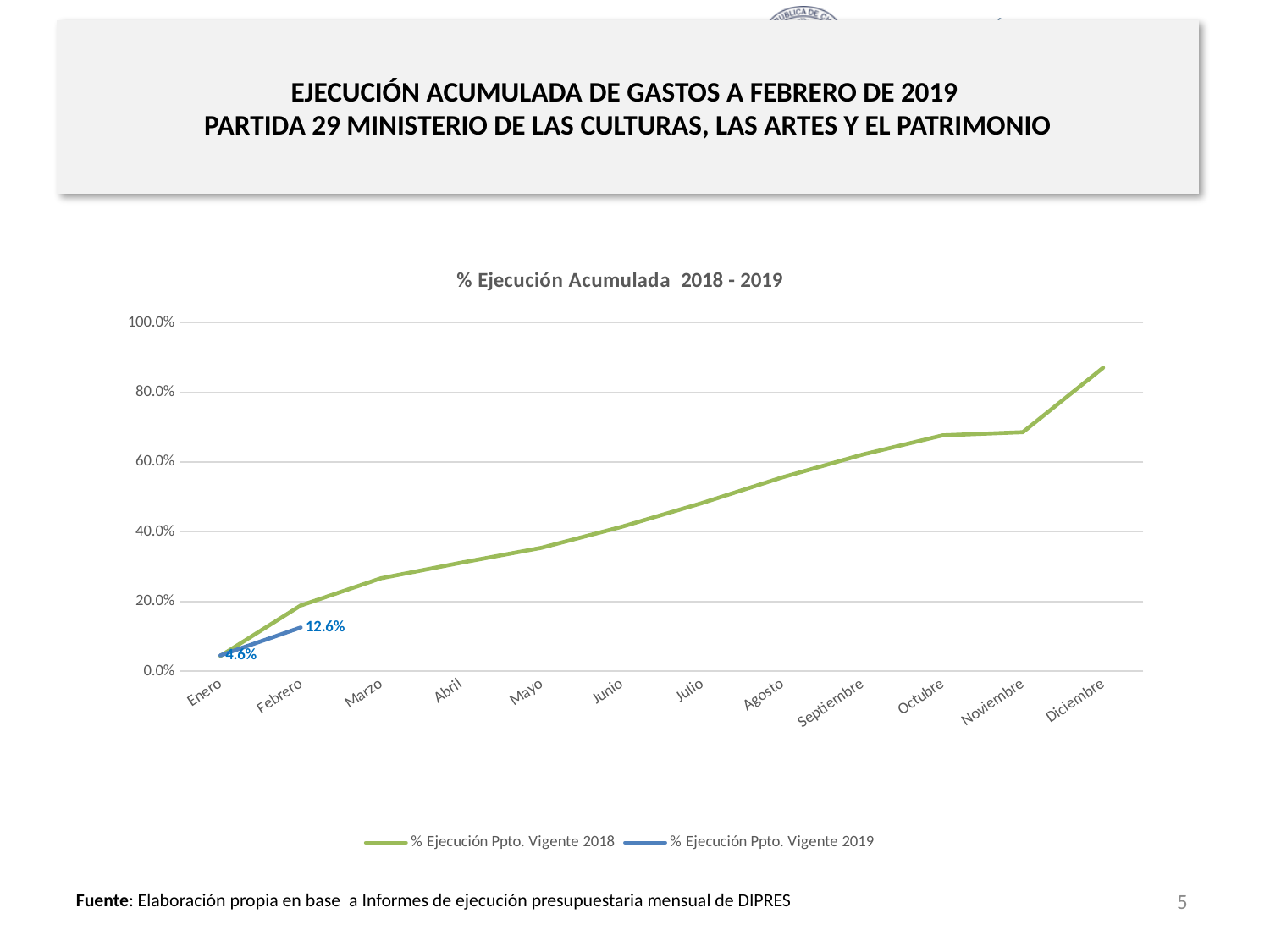
How many months are shown on the x axis? 12 What is the title of the chart? % Ejecución Acumulada 2018 - 2019 Is the value for Octubre in the % Ejecución Ppto. Vigente 2018 series greater or less than 60.0%? greater What kind of chart is shown on the slide? line chart In Febrero, which series has the larger value, % Ejecución Ppto. Vigente 2018 or % Ejecución Ppto. Vigente 2019? % Ejecución Ppto. Vigente 2018 What is the value for Febrero in the % Ejecución Ppto. Vigente 2019 series? 12.6% Is the value for Diciembre in the % Ejecución Ppto. Vigente 2018 series greater or less than 80.0%? greater What is the difference between the Febrero and Enero values of the % Ejecución Ppto. Vigente 2019 series? 8.0% How many series does the legend list? 2 Does the % Ejecución Ppto. Vigente 2018 line rise or fall from Enero to Diciembre? rise Which month has the highest value in the % Ejecución Ppto. Vigente 2018 series? Diciembre What is the value for Enero in the % Ejecución Ppto. Vigente 2019 series? 4.6%